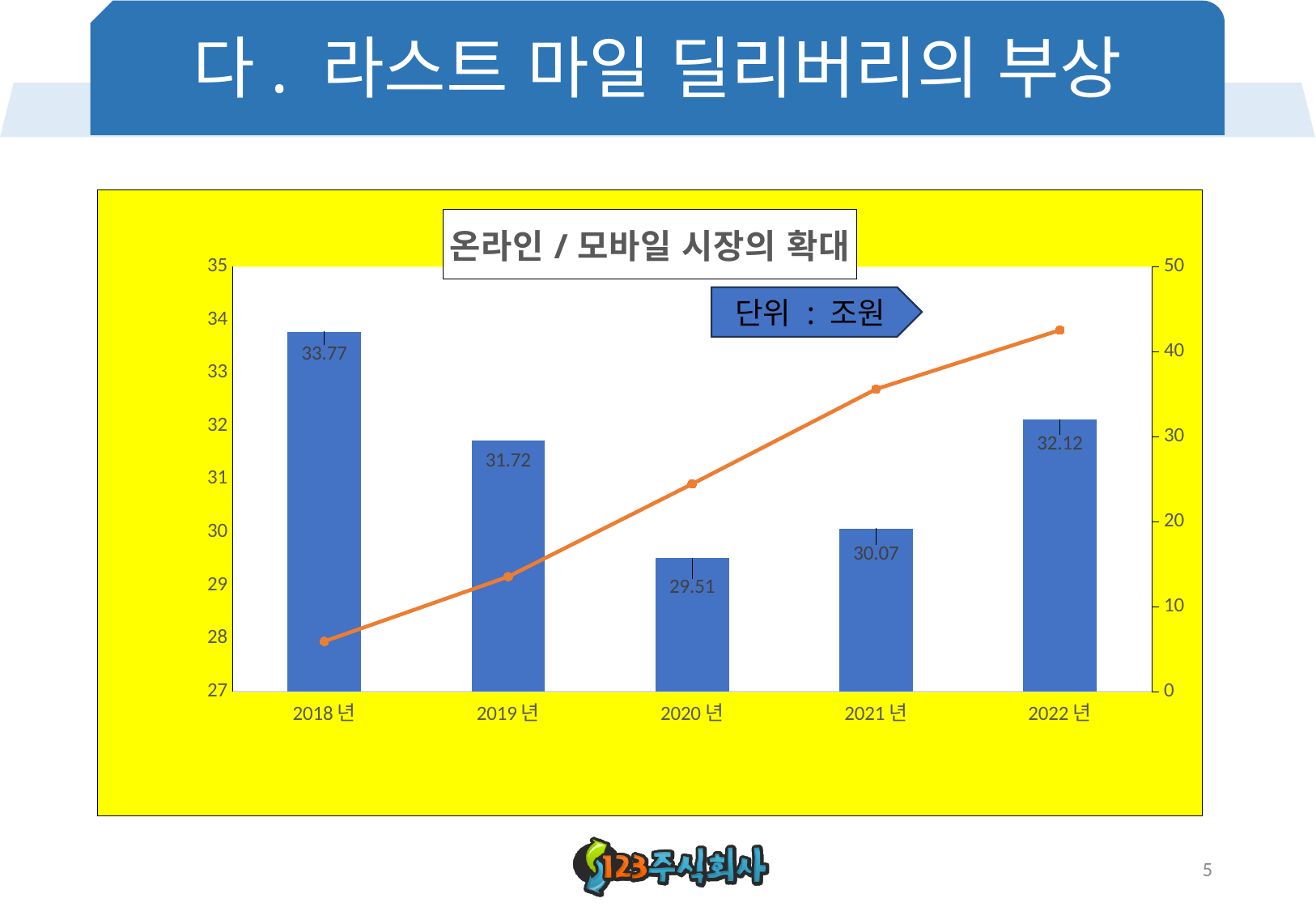
On the right axis, is the line value for 2018 년 greater or less than 10? less Which bar is larger, 2021 년 or 2022 년? 2022 년 What is the difference between the bar values for 2018 년 and 2019 년? 2.05 How many years are shown on the x axis? 5 Which year has the lowest bar value? 2020 년 What is the value of the bar for 2018 년? 33.77 Does the orange line rise or fall from 2018 년 to 2022 년? rise What is the title of the chart? 온라인 / 모바일 시장의 확대 Which year has the highest bar value? 2018 년 What is the value of the bar for 2022 년? 32.12 What is the value of the bar for 2020 년? 29.51 On the right axis, is the line value for 2022 년 greater or less than 40? greater